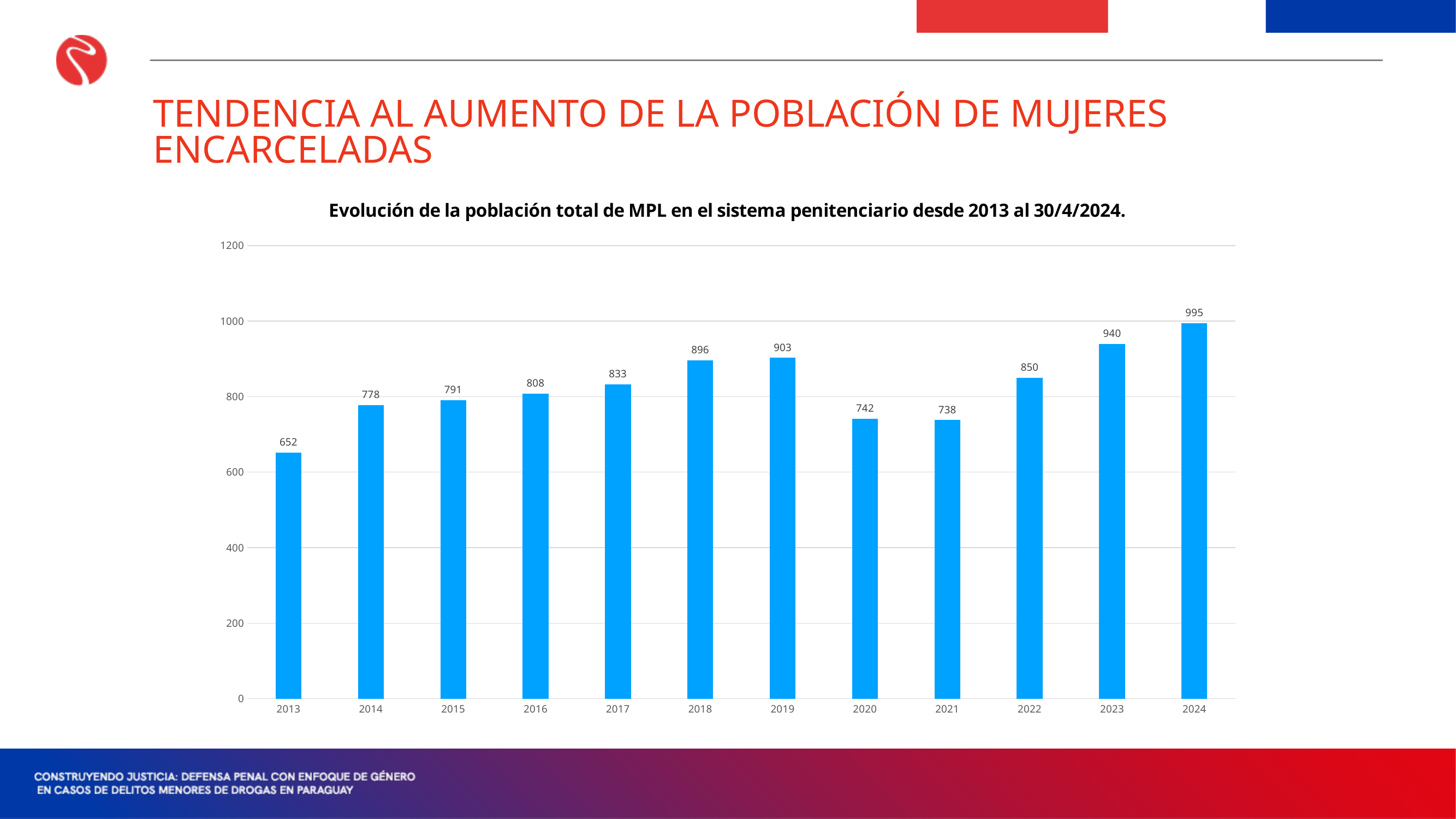
What kind of chart is shown on the slide? bar chart What is the value for 2013? 652 Is the value for 2021 greater or less than 800? less What is the title of the chart? Evolución de la población total de MPL en el sistema penitenciario desde 2013 al 30/4/2024. How many years are shown on the x axis? 12 Which is larger, the value for 2019 or the value for 2023? 2023 What is the difference between the values for 2024 and 2013? 343 Which year has the highest value? 2024 What is the difference between the values for 2019 and 2020? 161 What is the value for 2020? 742 What is the value for 2024? 995 Which year has the lowest value? 2013